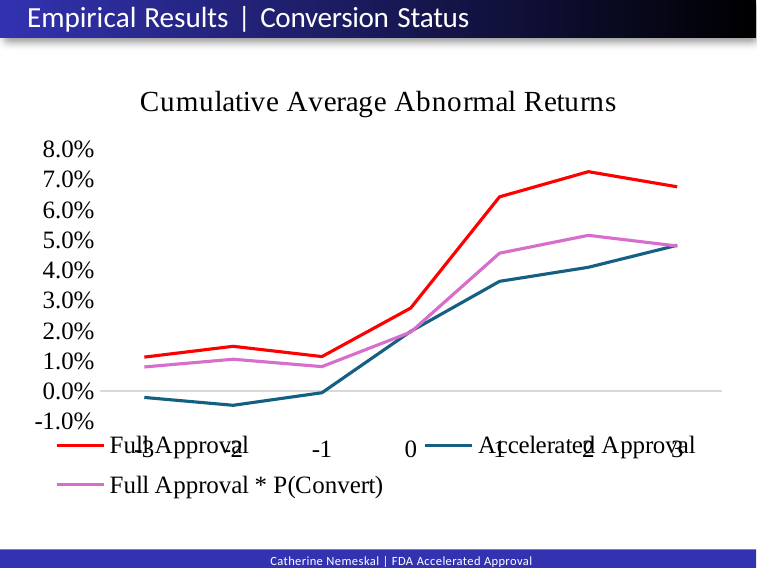
Is the value for Full Approval * P(Convert) at x = 2 greater or less than 4.0%? greater Does the Accelerated Approval line rise or fall from x = 0 to x = 3? rise What is the title of the chart? Cumulative Average Abnormal Returns How many series does the legend list? 3 Is the value for Full Approval at x = 2 greater or less than 6.0%? greater What kind of chart is shown on the slide? line chart How many points are plotted along the x axis for each series? 7 At x = 1, which is larger: Full Approval or Accelerated Approval? Full Approval What colour is the Full Approval line? red Which series has the lowest value at x = -2? Accelerated Approval Which series reaches the highest cumulative average abnormal return? Full Approval Is the value for Accelerated Approval at x = -2 greater or less than 0.0%? less